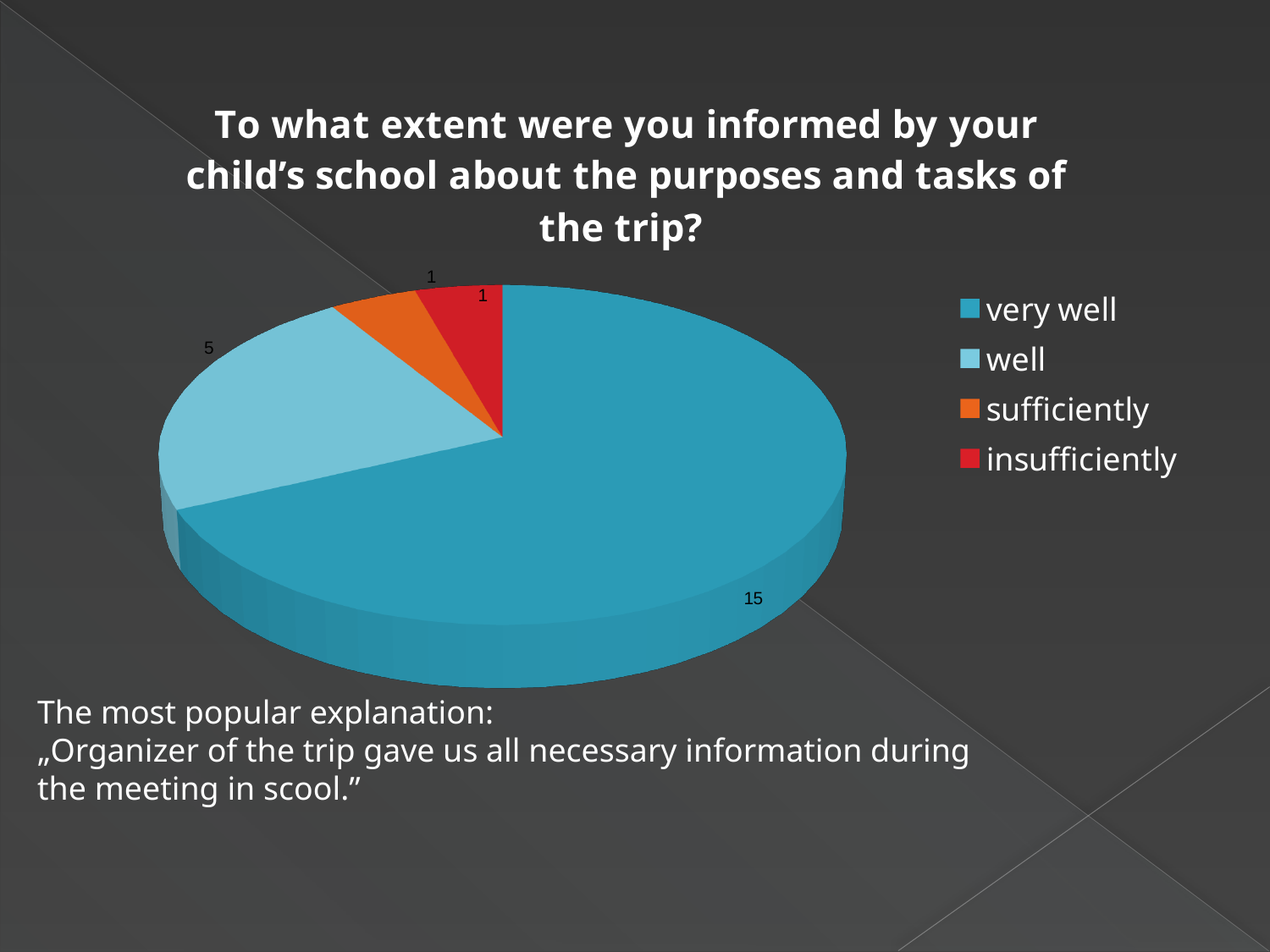
How many respondents answered "very well"? 15 Which colour represents the "insufficiently" category in the legend? red What is the total number of responses shown in the pie chart? 22 What is the difference between the number of "very well" and "well" responses? 10 What kind of chart is shown on the slide? pie chart Which has more responses, "well" or "sufficiently"? well How many respondents answered "well"? 5 Which response category has the largest slice of the pie? very well How many response categories does the pie chart show? 4 How many respondents answered "insufficiently"? 1 What is the title of the chart? To what extent were you informed by your child's school about the purposes and tasks of the trip? How many respondents answered "sufficiently"? 1